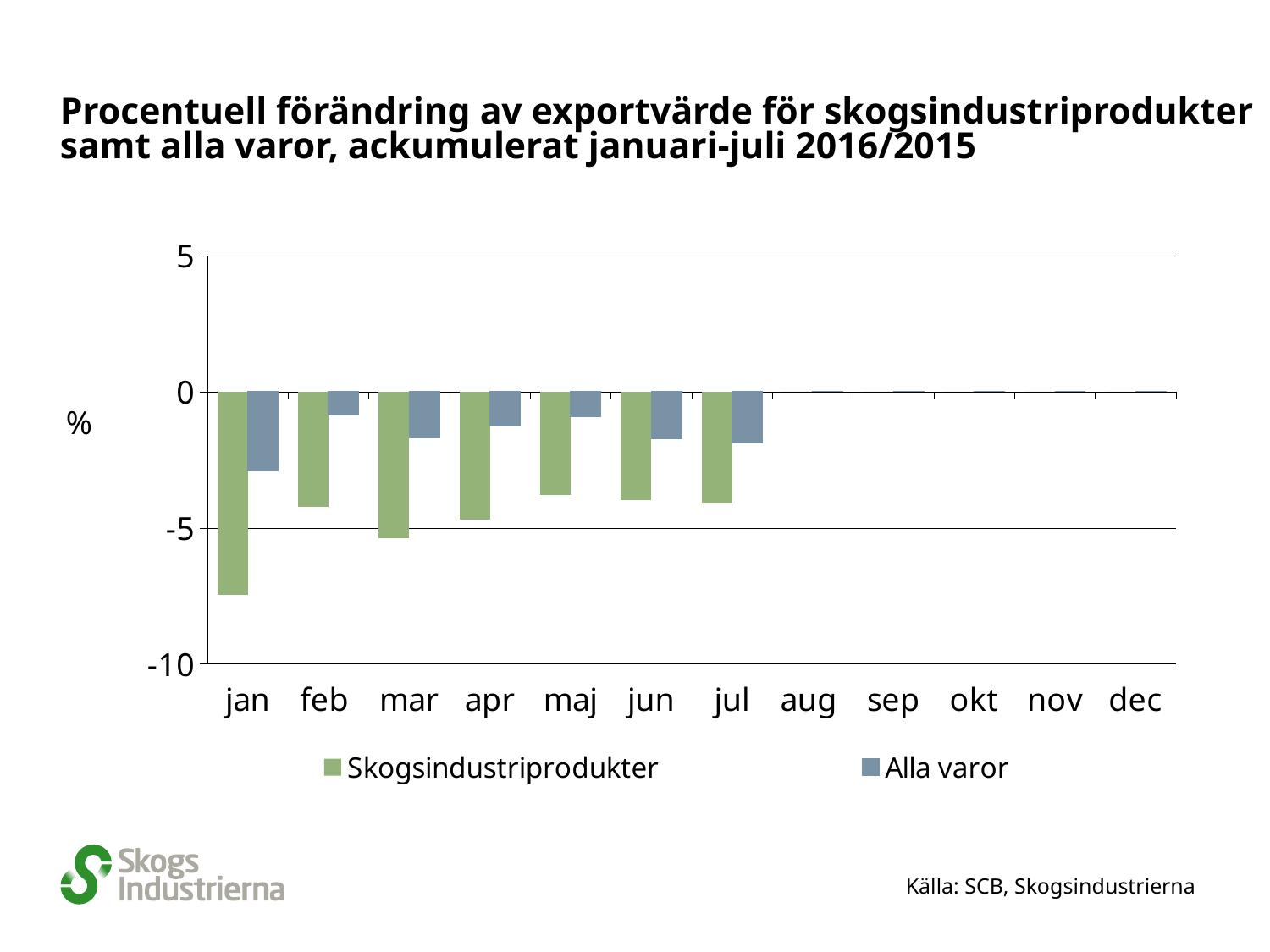
Is the value for Skogsindustriprodukter in feb greater or less than -5? greater How many month categories are shown along the x axis? 12 How many series does the legend list? 2 Which month has the lowest value for Alla varor? jan In jan, which series has the larger (less negative) value, Skogsindustriprodukter or Alla varor? Alla varor What are the two series named in the legend? Skogsindustriprodukter and Alla varor What kind of chart is shown on the slide? bar chart Is the value for Alla varor in jan greater or less than -5? greater Is the value for Skogsindustriprodukter in jan greater or less than -5? less What unit label is shown on the y axis? % For how many months are bars plotted? 7 Which month has the lowest value for Skogsindustriprodukter? jan